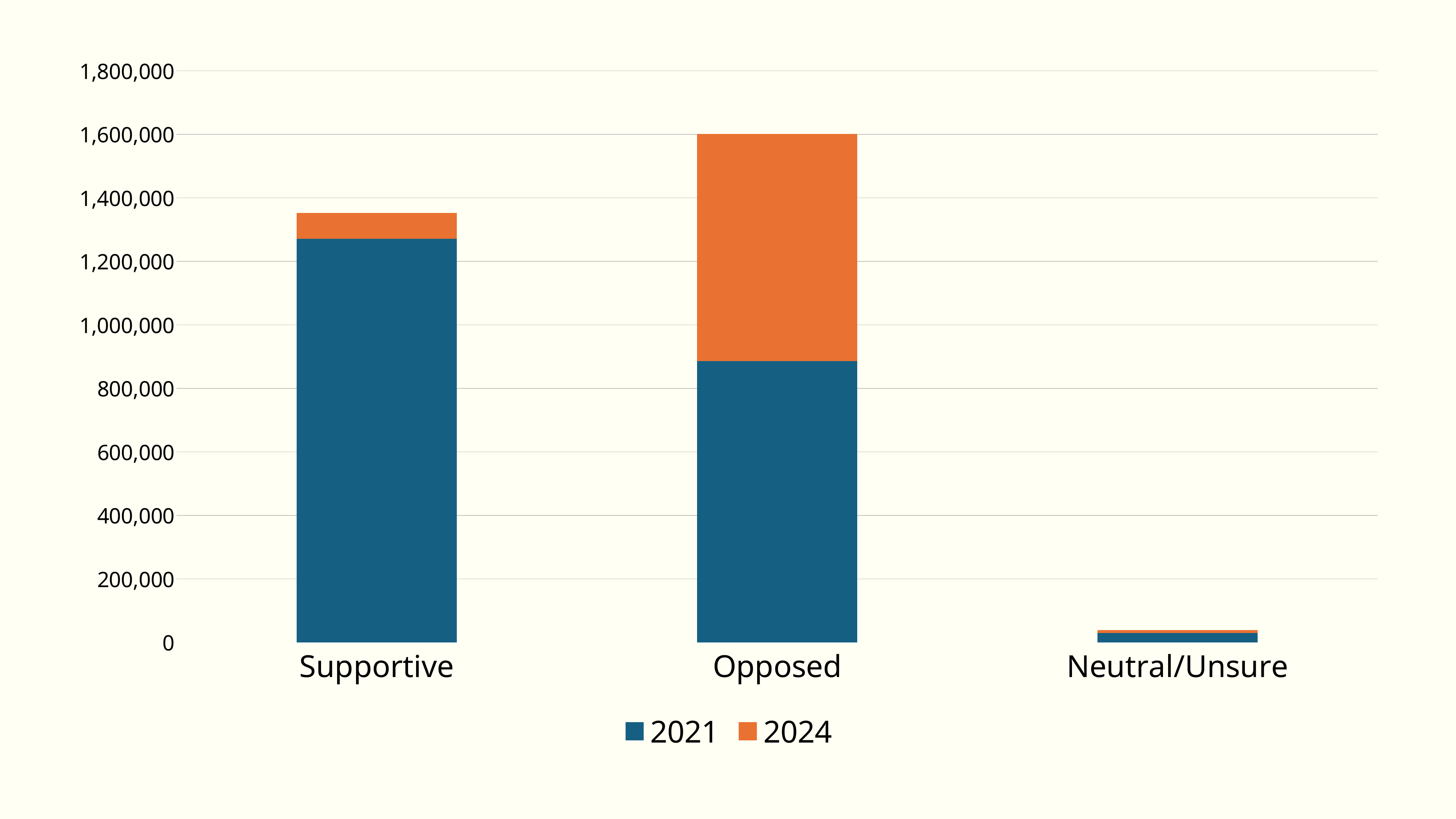
Is the 2024 value for Opposed greater or less than 600,000? greater Is the 2021 value for Opposed greater or less than 1,000,000? less Which is larger for the 2024 series: Supportive or Opposed? Opposed Which category has the tallest stacked bar? Opposed Is the 2021 value for Supportive greater or less than 1,200,000? greater How many categories are shown on the x axis? 3 Which category has the shortest stacked bar? Neutral/Unsure Which is larger for the 2021 series: Supportive or Opposed? Supportive What kind of chart is shown on the slide? Stacked bar chart How many series does the legend list? 2 Which colour represents the 2024 series in the legend? Orange